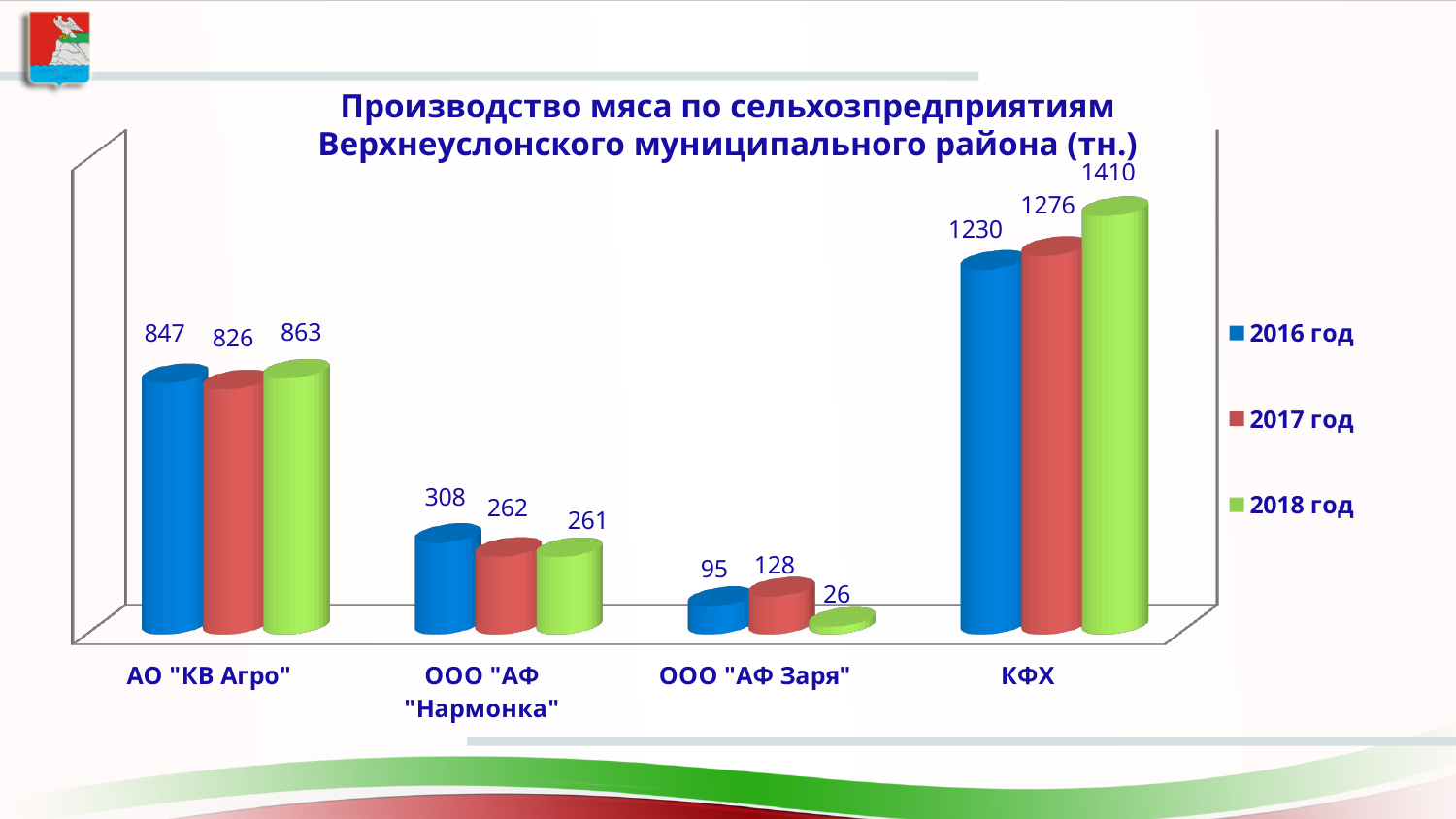
How many series does the legend list? 3 How many categories are shown on the x axis? 4 What is the value for КФХ in 2018 год? 1410 Do the values for ООО "АФ Заря" rise or fall from 2017 год to 2018 год? fall Which category has the highest value in 2018 год? КФХ Which category has the lowest value in 2016 год? ООО "АФ Заря" Which is larger for ООО "АФ "Нармонка": the 2016 год value or the 2017 год value? 2016 год What is the difference between the 2017 год and 2018 год values for ООО "АФ Заря"? 102 What is the difference between the 2018 год and 2016 год values for КФХ? 180 What is the value for ООО "АФ Заря" in 2017 год? 128 What is the value for АО "КВ Агро" in 2016 год? 847 What kind of chart is shown on the slide? bar chart